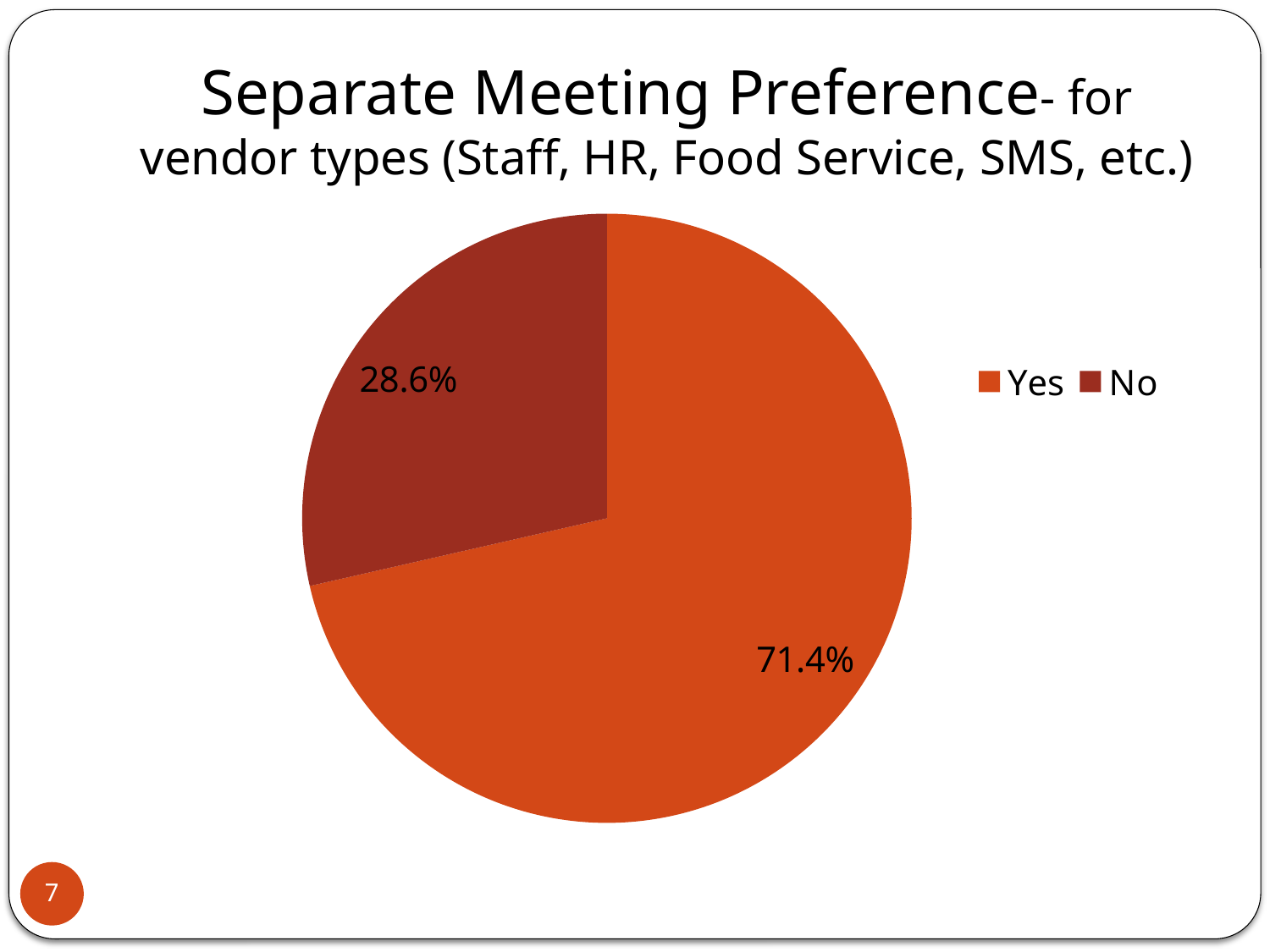
What kind of chart is shown on the slide? pie chart How many slices does the pie chart have? 2 How many entries does the legend list? 2 Which is larger, the share for Yes or the share for No? Yes Which colour represents the No slice in the legend? dark red Which response has the smallest share of the pie? No What percentage of respondents answered No? 28.6% What percentage of respondents answered Yes? 71.4% What is the share of the pie for the No slice? 28.6% What is the difference in percentage points between the Yes and No shares? 42.8 Which response has the largest share of the pie? Yes What is the title of the chart on the slide? Separate Meeting Preference- for vendor types (Staff, HR, Food Service, SMS, etc.)